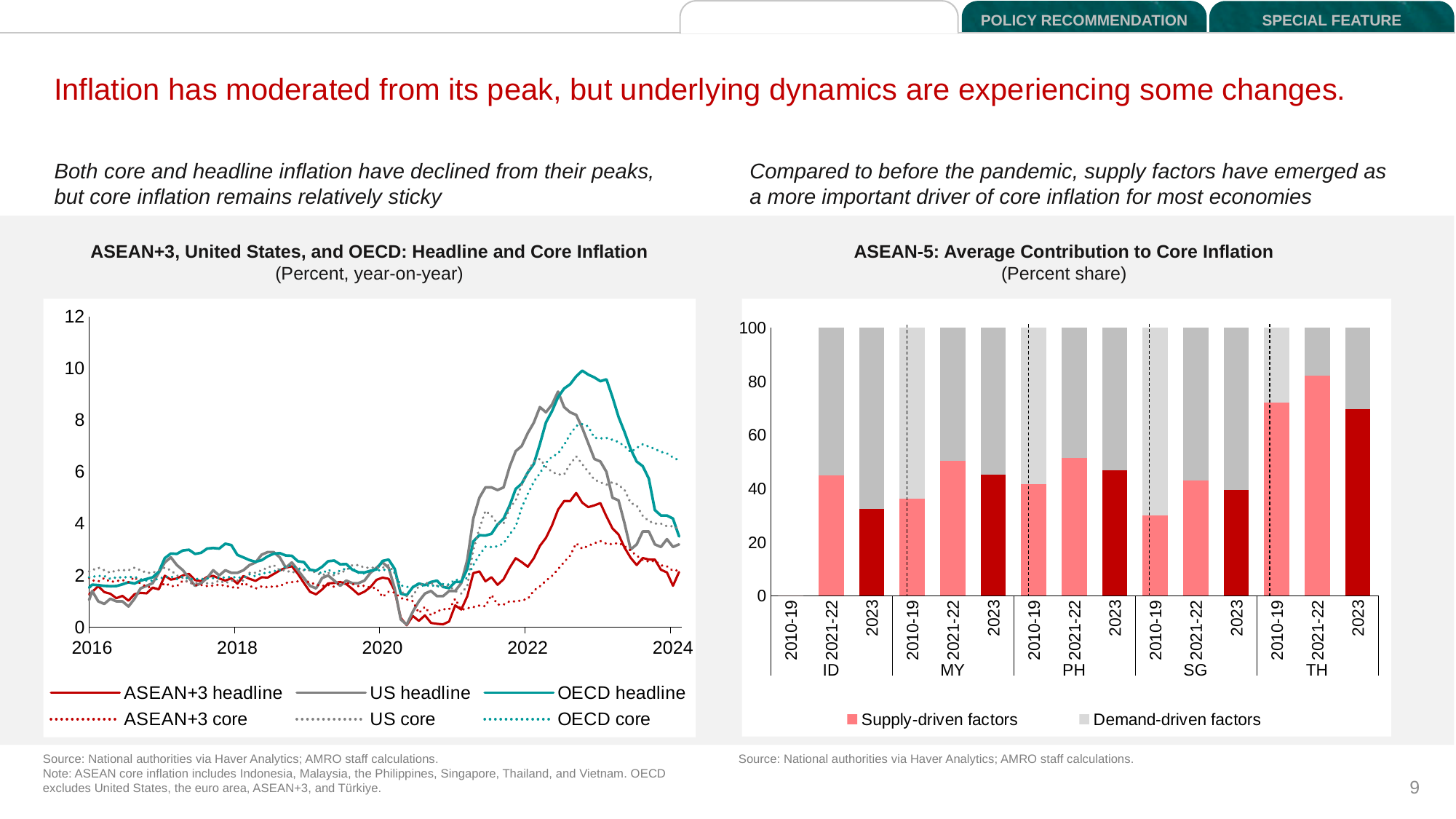
In the left chart, does OECD headline inflation rise or fall between its 2022 peak and 2024? fall How many economies are shown on the x axis of the right chart? 5 In the right chart, which economy has the highest supply-driven share in 2023? TH In the left chart, is the peak value of OECD headline inflation greater or less than 8? greater In the left chart, is the peak value of ASEAN+3 headline inflation greater or less than 6? less How many series does the legend of the left chart list? 6 How many series does the legend of the right chart list? 2 What kind of chart is the right chart, 'ASEAN-5: Average Contribution to Core Inflation'? Bar chart In the right chart, is the supply-driven share for SG in 2010-19 greater or less than 40? less In the left chart, which headline series reached the highest peak? OECD headline In the right chart, what is the total of the stacked bar for TH in 2023? 100 What kind of chart is the left chart, 'ASEAN+3, United States, and OECD: Headline and Core Inflation'? Line chart